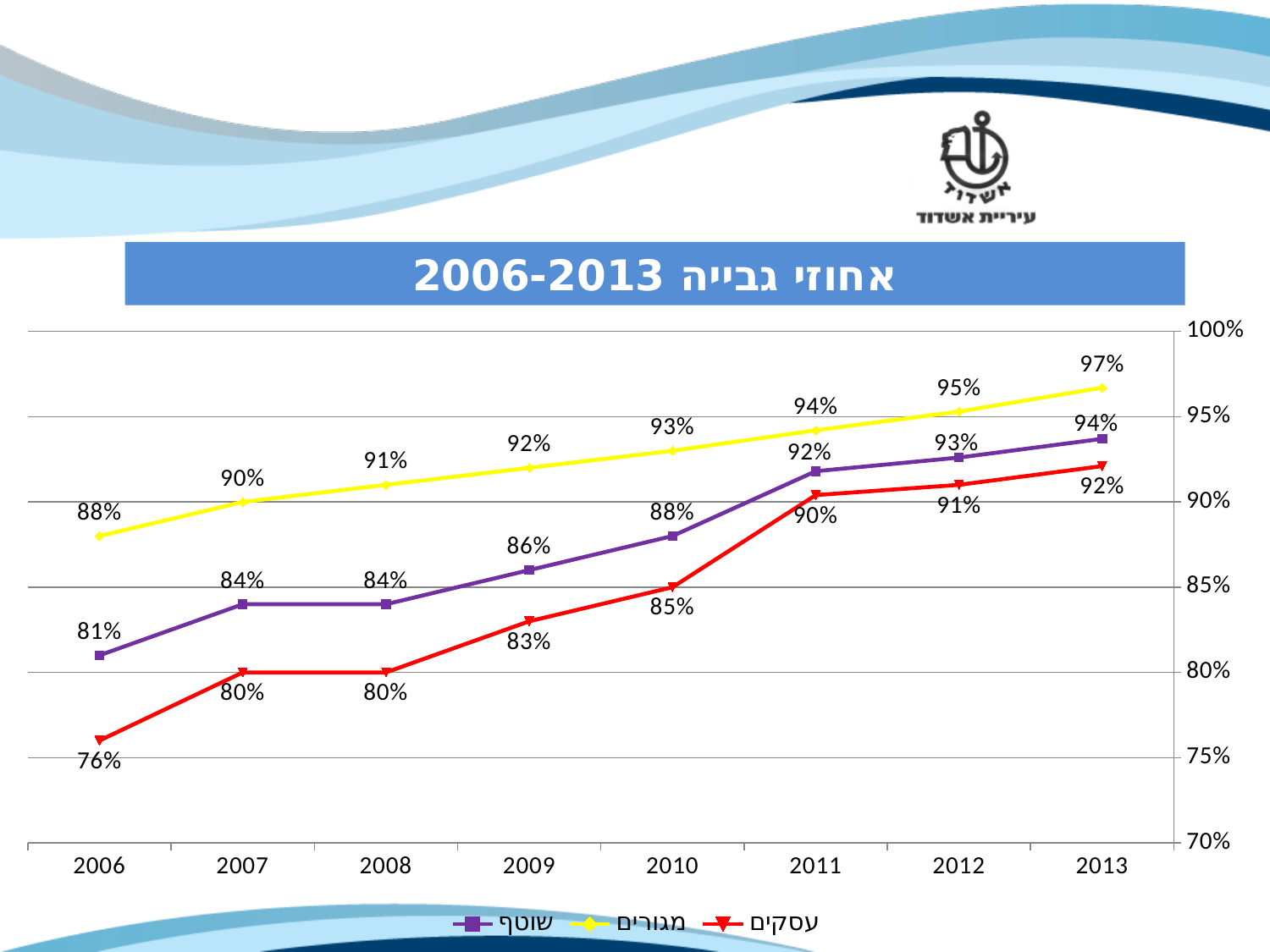
In which year is the value for שוטף highest? 2013 What is the title of the chart? אחוזי גבייה 2006-2013 What is the difference between the מגורים value and the עסקים value in 2006? 12% How many series does the legend list? 3 Which series has the larger value in 2011, שוטף or עסקים? שוטף Do the values for מגורים rise or fall from 2006 to 2013? rise What is the value for מגורים in 2013? 97% In which year is the value for עסקים lowest? 2006 What type of chart is shown on the slide? line chart What is the value for שוטף in 2010? 88% How many years are shown on the x axis? 8 What is the value for עסקים in 2006? 76%